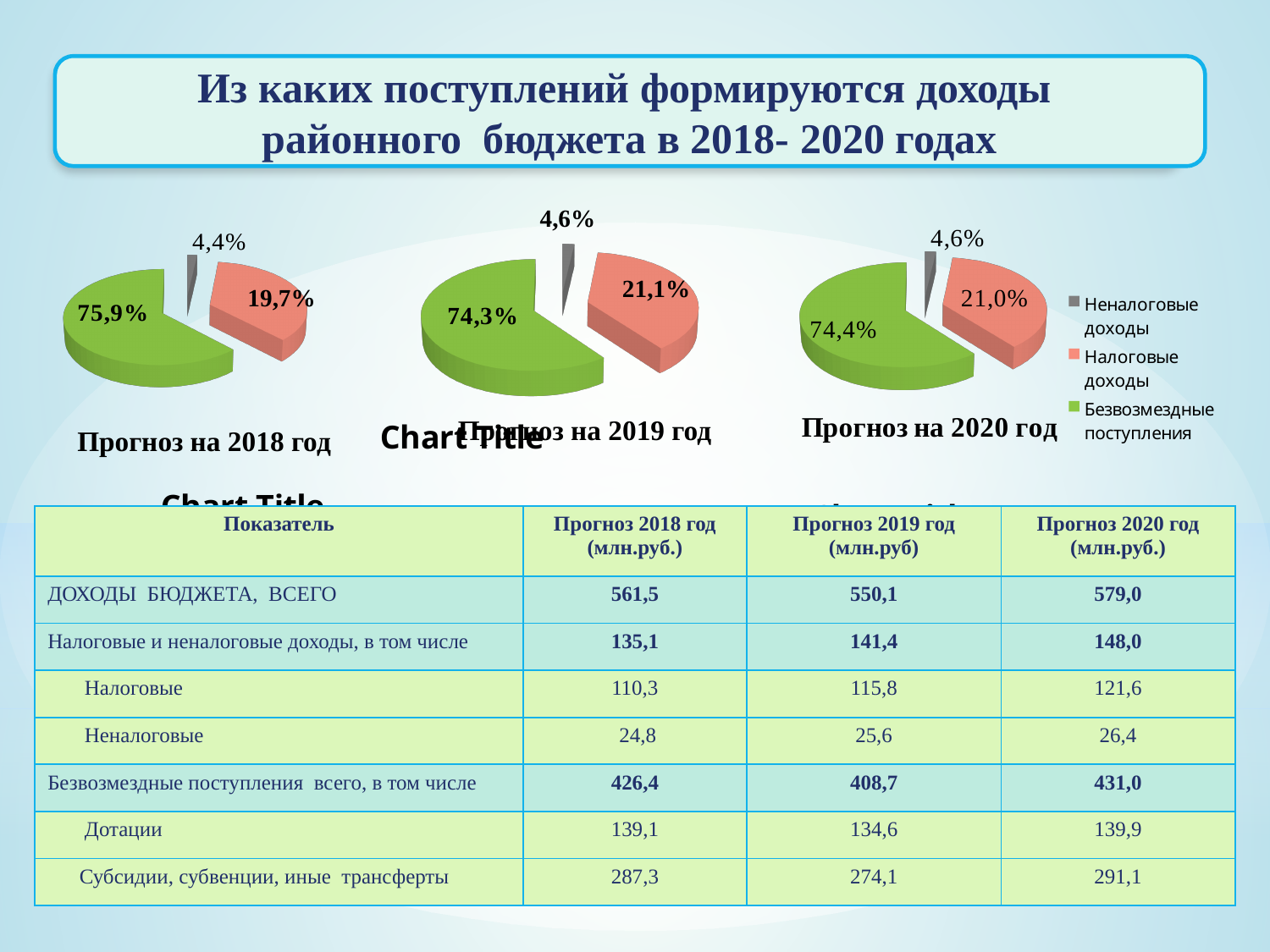
What type of chart is used for 'Прогноз на 2018 год'? Pie chart How many slices does the pie chart 'Прогноз на 2019 год' have? 3 Which is larger in the pie chart 'Прогноз на 2020 год': the share of Налоговые доходы or the share of Неналоговые доходы? Налоговые доходы In the pie chart 'Прогноз на 2018 год', what share is shown for Безвозмездные поступления? 75,9% In the legend next to the pie charts, which category is shown in green? Безвозмездные поступления In the pie chart 'Прогноз на 2018 год', what share is shown for Неналоговые доходы? 4,4% In the pie chart 'Прогноз на 2019 год', which category has the smallest slice? Неналоговые доходы In the pie chart 'Прогноз на 2020 год', which category has the largest slice? Безвозмездные поступления In the pie chart 'Прогноз на 2018 год', what is the difference between the shares of Безвозмездные поступления and Налоговые доходы? 56,2% How many entries does the legend next to the pie charts list? 3 In the pie chart 'Прогноз на 2020 год', what share is shown for Неналоговые доходы? 4,6% In the pie chart 'Прогноз на 2019 год', what share is shown for Налоговые доходы? 21,1%